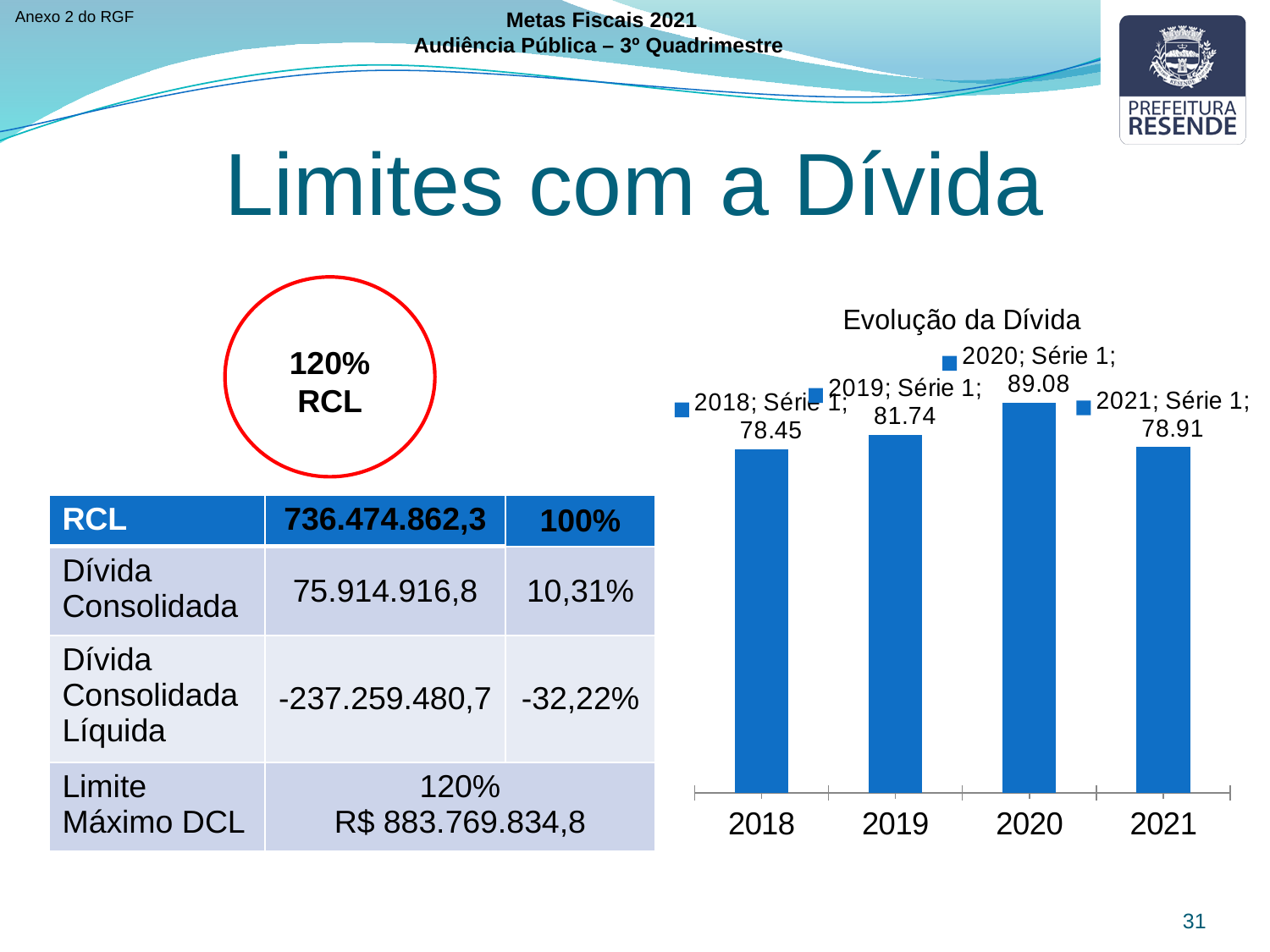
What type of chart is 'Evolução da Dívida'? bar chart In the 'Evolução da Dívida' chart, what is the value for 2019? 81.74 How many years are shown in the 'Evolução da Dívida' chart? 4 In the 'Evolução da Dívida' chart, what is the value for 2020? 89.08 In the 'Evolução da Dívida' chart, what is the difference between the values for 2020 and 2019? 7.34 In the 'Evolução da Dívida' chart, what is the value for 2021? 78.91 In the 'Evolução da Dívida' chart, which year has the lowest value? 2018 In the 'Evolução da Dívida' chart, which year has the highest value? 2020 In the 'Evolução da Dívida' chart, which is larger, the value for 2019 or the value for 2021? 2019 In the 'Evolução da Dívida' chart, what is the value for 2018? 78.45 What is the title of the chart on the slide? Evolução da Dívida In the 'Evolução da Dívida' chart, does the value rise or fall from 2020 to 2021? fall